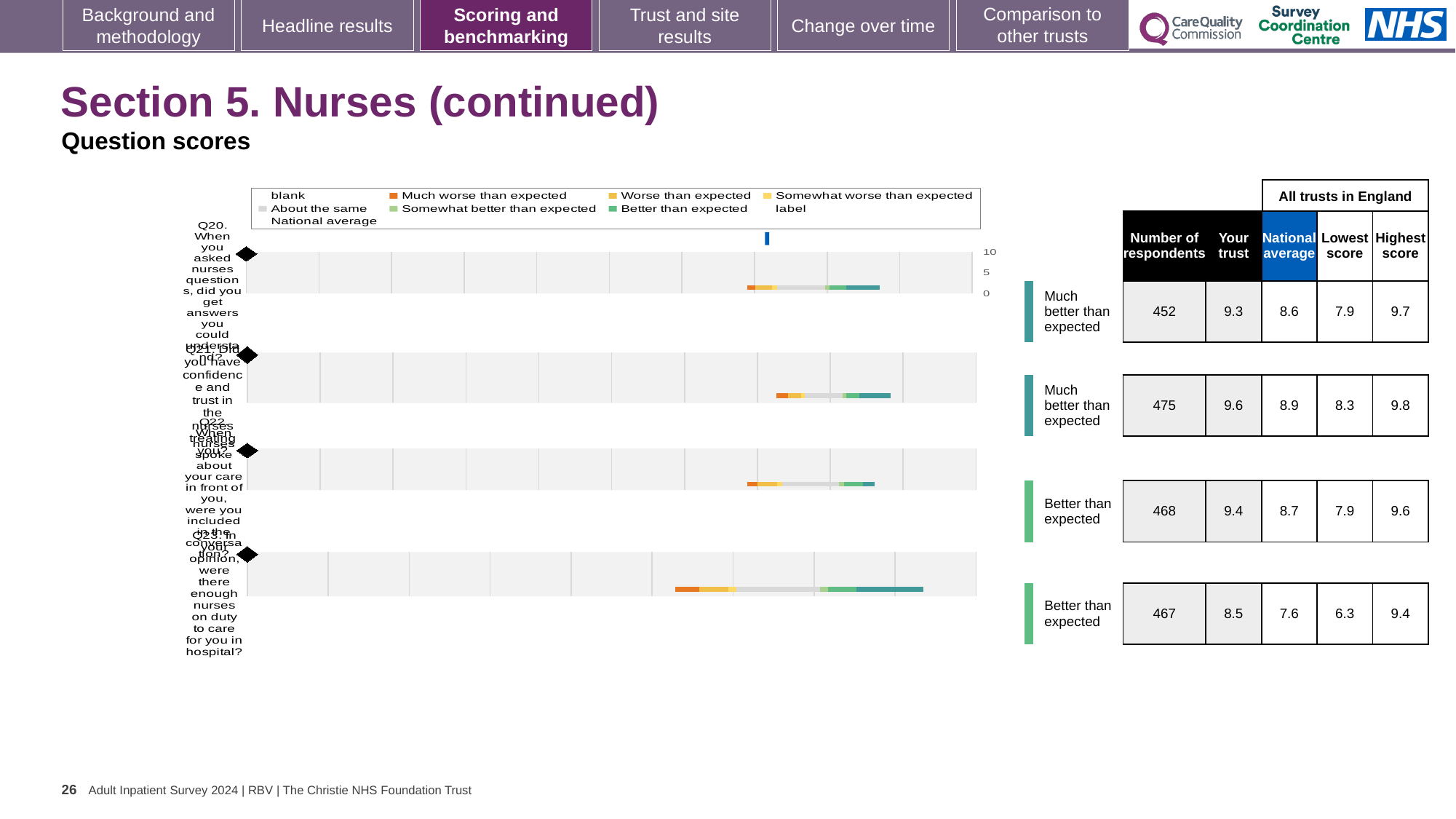
For the Q21 chart, what is the national average score shown in the table? 8.9 Which question (Q20 to Q23) has the lowest 'Your trust' score? Q23 Which question (Q20 to Q23) has the highest 'Your trust' score? Q21 How many question charts (Q20 to Q23) are shown on the slide? 4 What is the highest tick value shown on the x axis of the question score charts? 10 For Q23, what benchmark category is shown next to the chart? Better than expected For Q23, what is the difference between the 'Your trust' score and the national average? 0.9 For the Q20 chart, what is the 'Your trust' score shown in the table? 9.3 For the Q22 chart, how many respondents are shown in the table? 468 Which legend entry is shown in dark orange on the question score charts? Much worse than expected What kind of chart is used to show the question scores for Q20 to Q23? bar chart For the Q23 chart, what is the lowest score among all trusts in England? 6.3